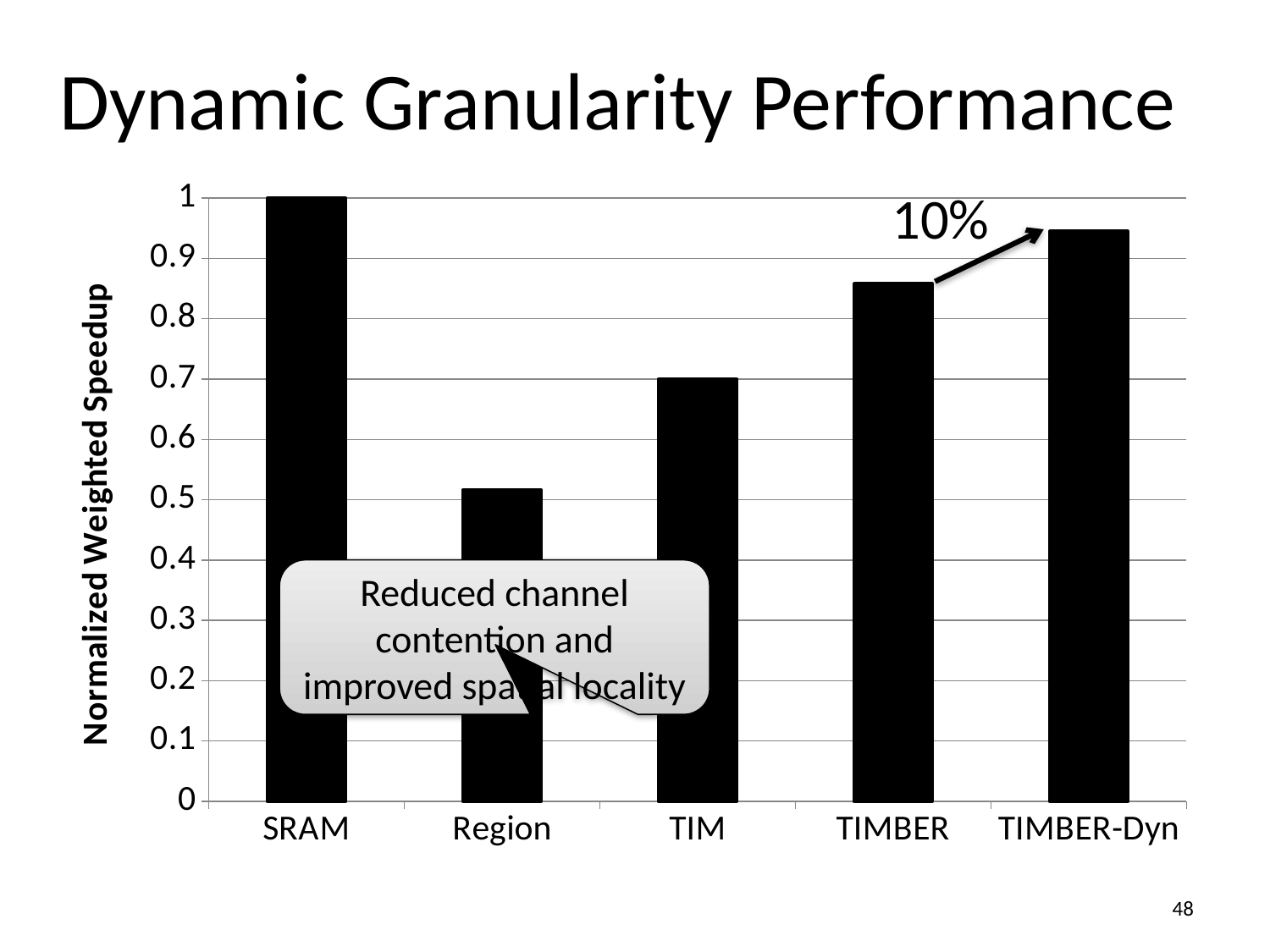
Which category has the lowest normalized weighted speedup? Region What kind of chart is shown on the slide? bar chart Which category has the highest normalized weighted speedup? SRAM Is the value for Region greater or less than 0.6? less Which has a higher normalized weighted speedup, TIMBER or TIMBER-Dyn? TIMBER-Dyn How many categories are plotted on the x axis? 5 What percentage is annotated next to the arrow between TIMBER and TIMBER-Dyn? 10% Is the value for TIM greater or less than 0.6? greater What is the normalized weighted speedup for SRAM? 1 Is the value for TIMBER greater or less than 0.8? greater What is the label of the y axis? Normalized Weighted Speedup